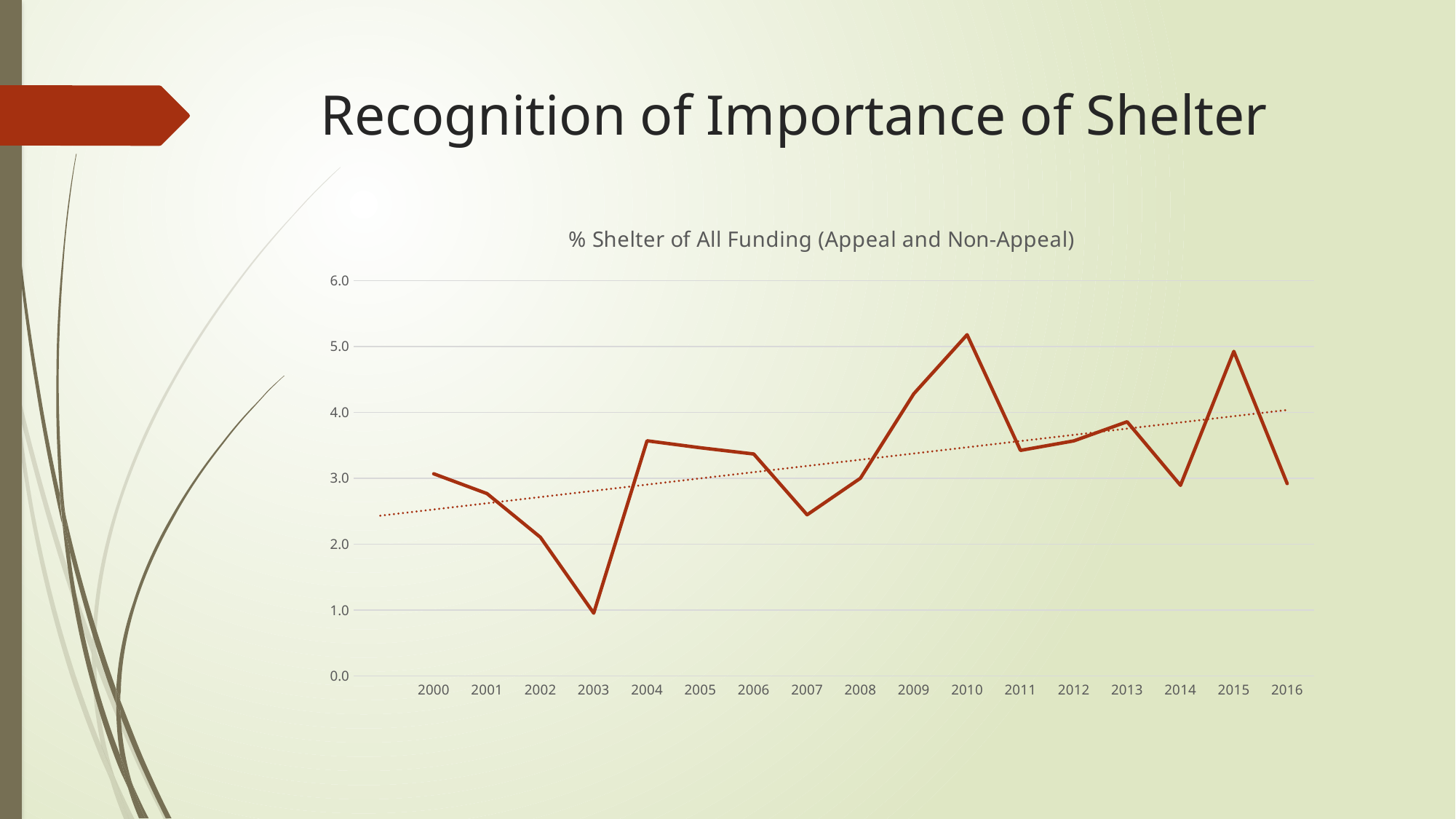
Is the value for 2009 greater or less than 4.0? greater In which year is the % shelter of all funding highest? 2010 Is the value for 2003 greater or less than 2.0? less Is the value for 2007 greater or less than 3.0? less Does the dotted trend line rise or fall from 2000 to 2016? rise Which year has the larger value, 2009 or 2011? 2009 What is the title of the chart? % Shelter of All Funding (Appeal and Non-Appeal) What kind of chart is shown on the slide? line chart How many years are plotted along the x axis? 17 In which year is the % shelter of all funding lowest? 2003 Which year has the larger value, 2003 or 2007? 2007